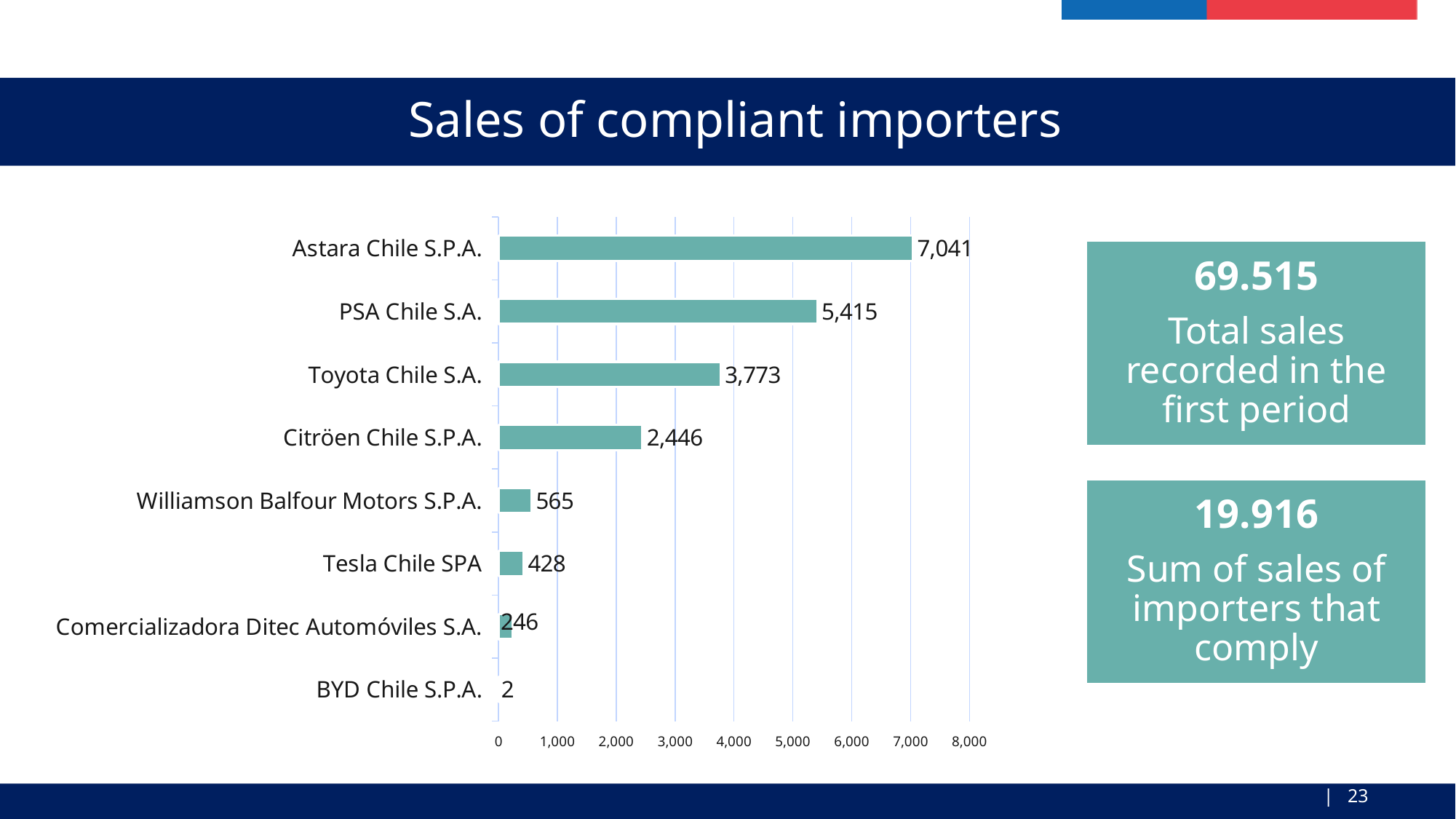
Is the value for PSA Chile S.A. greater or less than 5,000? greater Which is larger, the value for Citröen Chile S.P.A. or the value for Toyota Chile S.A.? Toyota Chile S.A. Which importer has the highest sales in the chart? Astara Chile S.P.A. What is the value for Toyota Chile S.A.? 3,773 What is the value for BYD Chile S.P.A.? 2 What is the value for Astara Chile S.P.A.? 7,041 How many importers are shown in the chart? 8 What is the value for Tesla Chile SPA? 428 What kind of chart is shown on the slide? Bar chart What is the difference between the values for Astara Chile S.P.A. and PSA Chile S.A.? 1,626 What is the difference between the values for Williamson Balfour Motors S.P.A. and Tesla Chile SPA? 137 Which importer has the lowest sales in the chart? BYD Chile S.P.A.